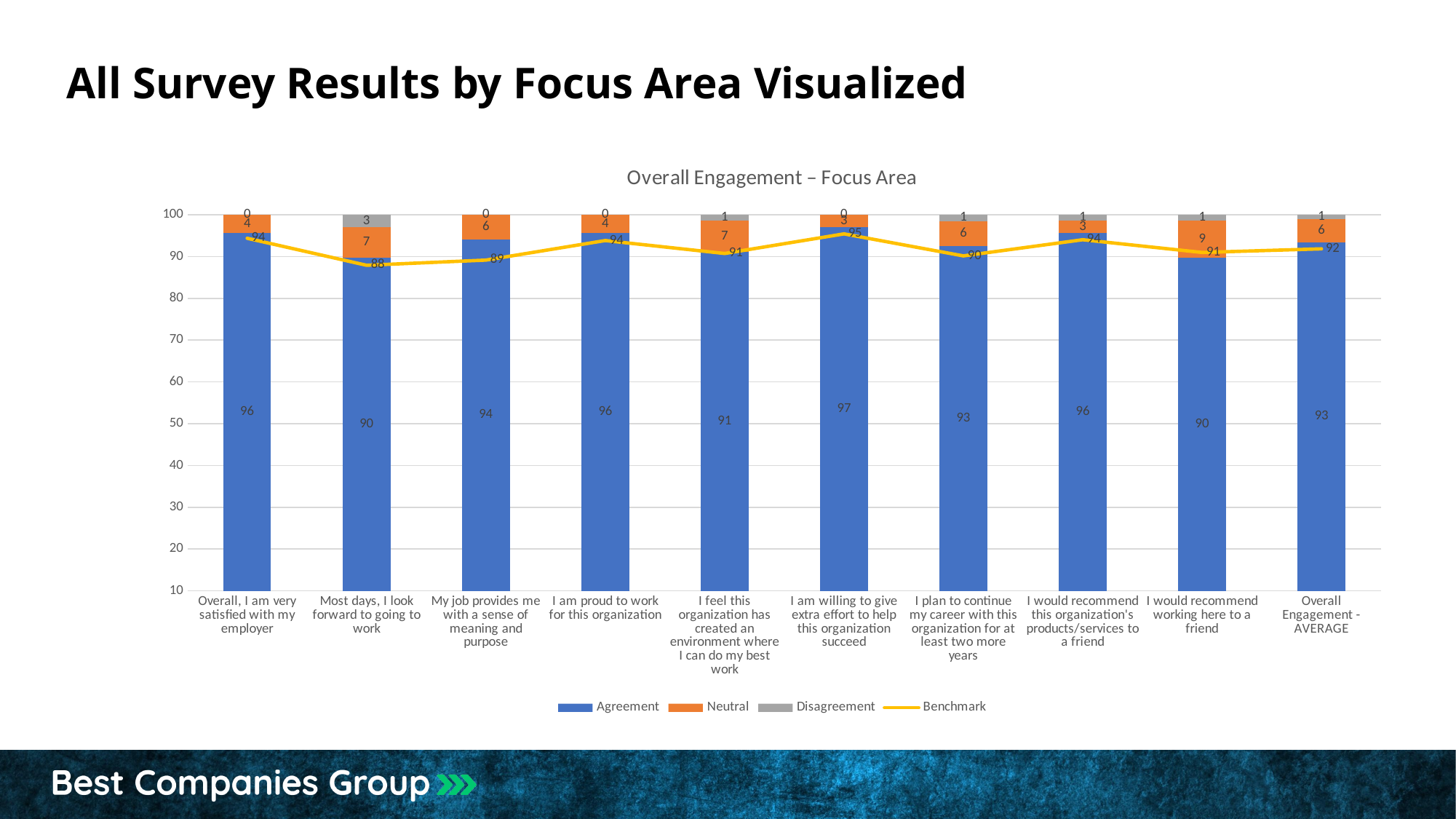
What is the Agreement value for "Overall Engagement - AVERAGE"? 93 What is the Agreement value for "I am willing to give extra effort to help this organization succeed"? 97 How many series does the legend list? 4 How many statements (categories) are shown on the x axis? 10 Which statement has the highest Agreement value? I am willing to give extra effort to help this organization succeed Which statement has the highest Neutral value? I would recommend working here to a friend Which is larger: the Agreement value for "I am proud to work for this organization" or the Agreement value for "I feel this organization has created an environment where I can do my best work"? I am proud to work for this organization What is the Benchmark value for "My job provides me with a sense of meaning and purpose"? 89 What is the Neutral value for "Most days, I look forward to going to work"? 7 What is the title of the chart? Overall Engagement – Focus Area Which statement has the lowest Benchmark value? Most days, I look forward to going to work What is the difference between the Agreement value and the Benchmark value for "I plan to continue my career with this organization for at least two more years"? 3